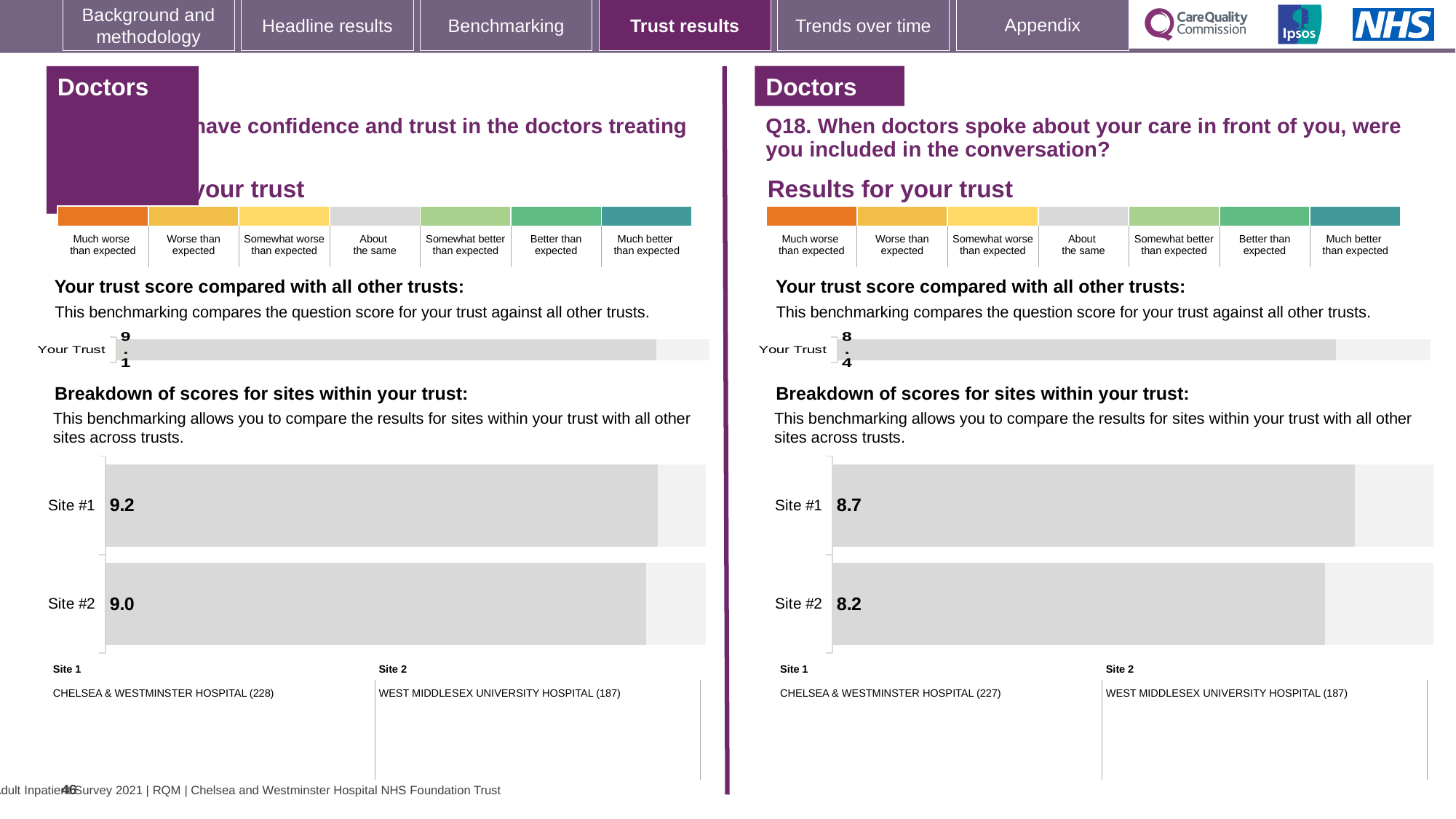
On the Q18 site breakdown chart, which site has the higher score? Site #1 On the Q18 site breakdown chart, which site has the lower score? Site #2 On the Q18 'Your trust score compared with all other trusts' chart, what is the value for Your Trust? 8.4 On the left-hand site breakdown chart, what is the score for Site #1? 9.2 What type of chart is used for the Q18 site breakdown? Bar chart On the left-hand site breakdown chart, what is the score for Site #2? 9.0 On the left-hand site breakdown chart, what is the difference between the Site #1 and Site #2 scores? 0.2 On the left-hand site breakdown chart, how many sites are shown? 2 On the Q18 site breakdown chart, what is the score for Site #2? 8.2 On the Q18 site breakdown chart, what is the score for Site #1? 8.7 On the Q18 site breakdown chart, what is the difference between the Site #1 and Site #2 scores? 0.5 On the left-hand 'Your trust score compared with all other trusts' chart, what is the value for Your Trust? 9.1